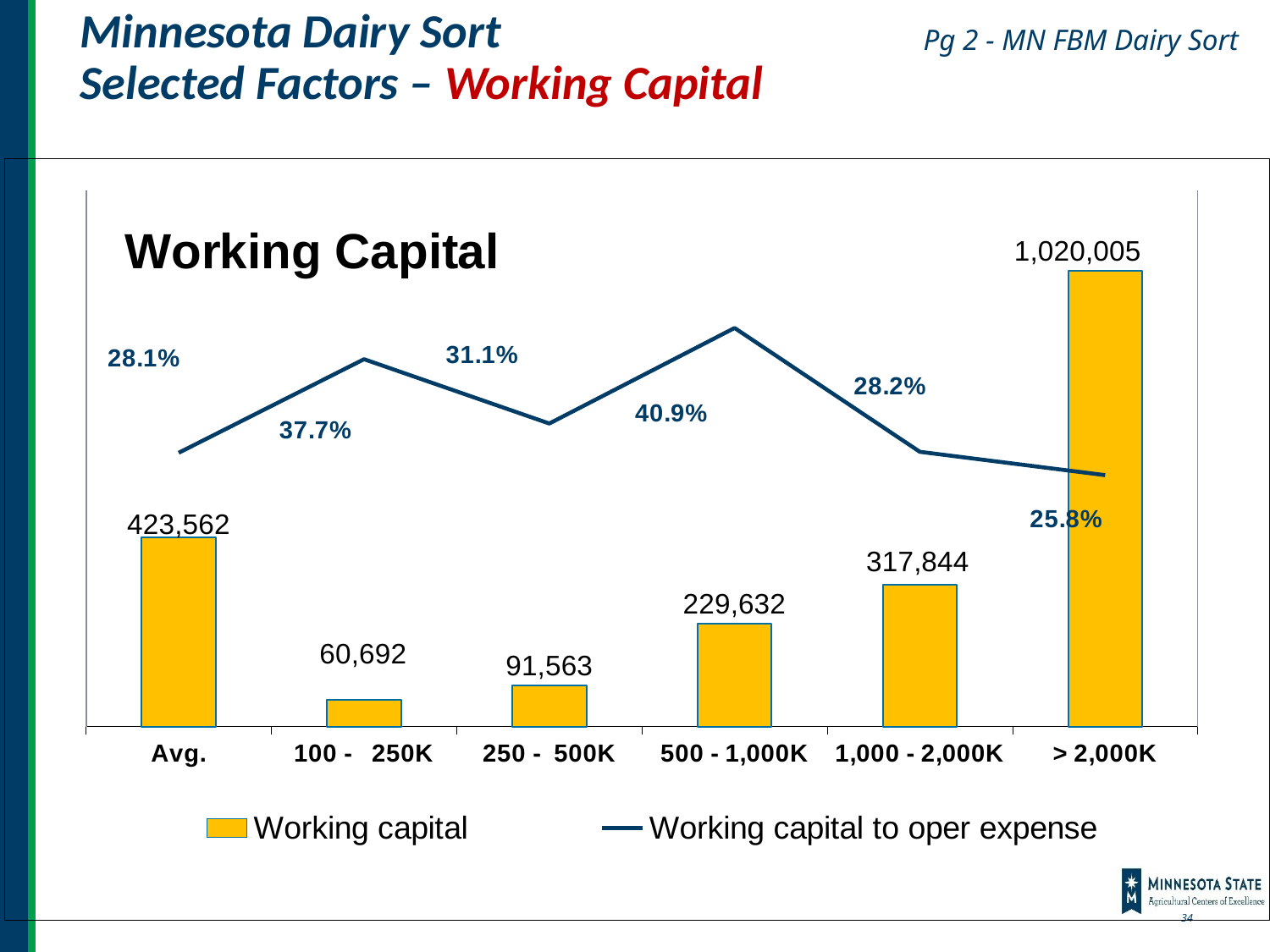
Which category has the lowest working capital? 100 - 250K What kind of chart is used to show the working capital values? Bar chart How many series does the legend list? 2 How many categories are shown on the x axis? 6 What is the working capital value for the > 2,000K category? 1,020,005 What is the working capital value for the Avg. category? 423,562 Which category has the highest working capital? > 2,000K What is the title of the chart? Working Capital Which has a larger working capital, the 250 - 500K category or the 500 - 1,000K category? 500 - 1,000K What is the working capital to oper expense percentage for the 500 - 1,000K category? 40.9% What is the working capital value for the 100 - 250K category? 60,692 What is the difference in working capital between the 1,000 - 2,000K and 500 - 1,000K categories? 88,212